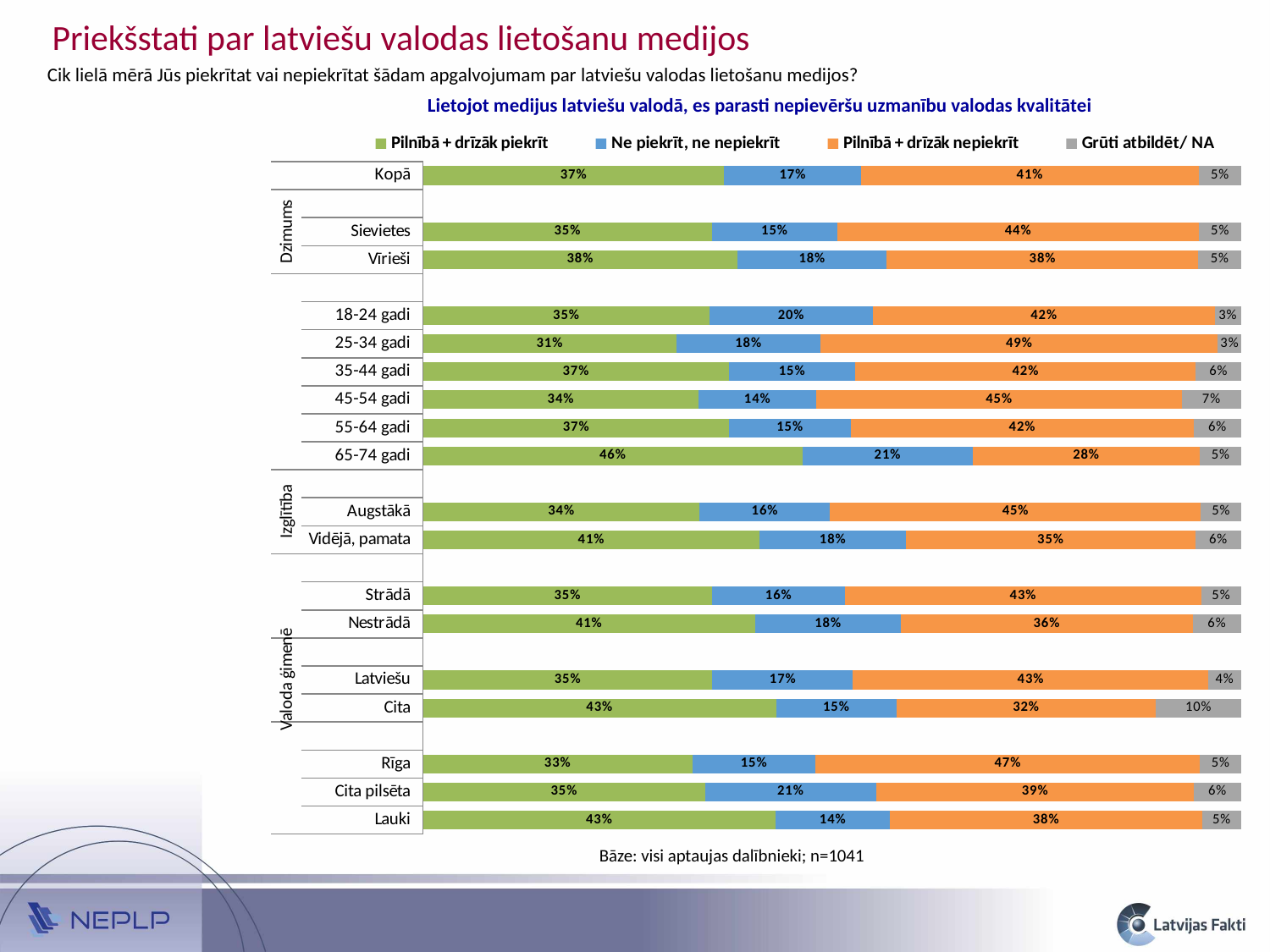
Which category has the highest value for "Grūti atbildēt/ NA"? Cita What kind of chart is shown on the slide? stacked bar chart What is the value of "Pilnībā + drīzāk piekrīt" for Kopā? 37% What is the difference between the "Pilnībā + drīzāk nepiekrīt" values for Rīga and Lauki? 9% How many series does the legend list? 4 What is the value of "Grūti atbildēt/ NA" for Cita? 10% Which is larger: the "Ne piekrīt, ne nepiekrīt" value for 18-24 gadi or for 45-54 gadi? 18-24 gadi What is the value of "Ne piekrīt, ne nepiekrīt" for Cita pilsēta? 21% What is the value of "Pilnībā + drīzāk nepiekrīt" for Sievietes? 44% How many categories (bars) are plotted in the chart? 18 Which category has the highest value for "Pilnībā + drīzāk piekrīt"? 65-74 gadi Which category has the highest value for "Pilnībā + drīzāk nepiekrīt"? 25-34 gadi